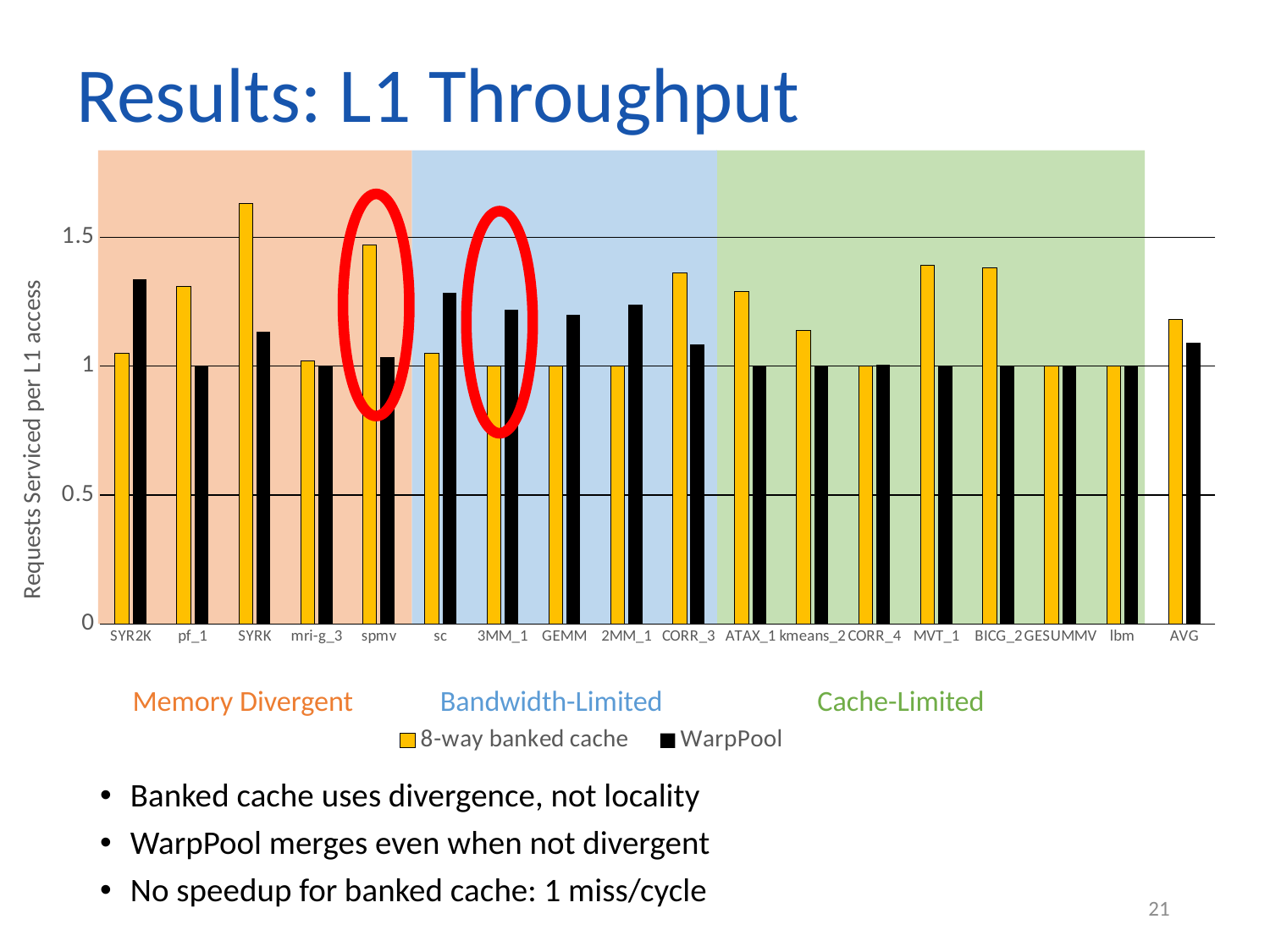
Is the WarpPool value for SYR2K greater or less than 1? greater Which category has the highest value for the 8-way banked cache series? SYRK Is the 8-way banked cache value for SYRK greater or less than 1.5? greater What kind of chart is shown on the slide? bar chart Is the 8-way banked cache value for MVT_1 greater or less than 1.5? less For CORR_3, which series has the larger value: 8-way banked cache or WarpPool? 8-way banked cache For SYR2K, which series has the larger value: 8-way banked cache or WarpPool? WarpPool What are the two series named in the legend? 8-way banked cache and WarpPool What is the label of the y axis? Requests Serviced per L1 access For sc, which series has the larger value: 8-way banked cache or WarpPool? WarpPool How many series does the legend list? 2 How many categories are shown along the x axis? 18